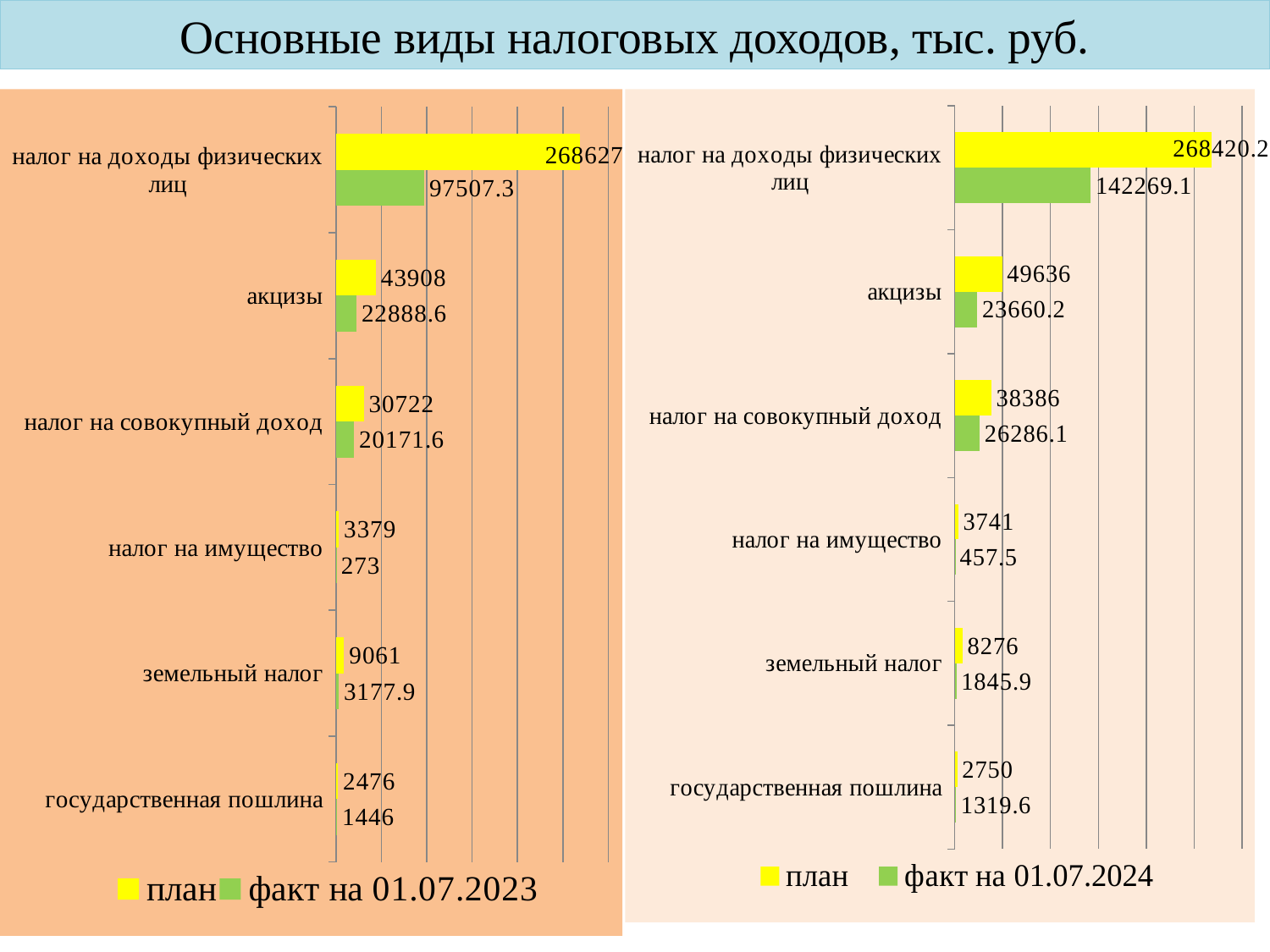
In the left chart (факт на 01.07.2023), what is the факт value for акцизы? 22888.6 How many series does the legend of the right chart (факт на 01.07.2024) list? 2 In the right chart (факт на 01.07.2024), what is the difference between the план and факт values for акцизы? 25975.8 In the left chart (факт на 01.07.2023), what is the план value for налог на доходы физических лиц? 268627 In the left chart (факт на 01.07.2023), which category has the lowest факт value? налог на имущество In the right chart (факт на 01.07.2024), which is larger: the факт value for налог на совокупный доход or the факт value for акцизы? налог на совокупный доход In the right chart (факт на 01.07.2024), what is the план value for земельный налог? 8276 In the right chart (факт на 01.07.2024), what is the факт value for налог на доходы физических лиц? 142269.1 What type of chart is the left chart (факт на 01.07.2023)? bar chart In the right chart (факт на 01.07.2024), which category has the highest план value? налог на доходы физических лиц In the left chart (факт на 01.07.2023), what is the difference between the план and факт values for налог на доходы физических лиц? 171119.7 How many categories are shown in the left chart (факт на 01.07.2023)? 6